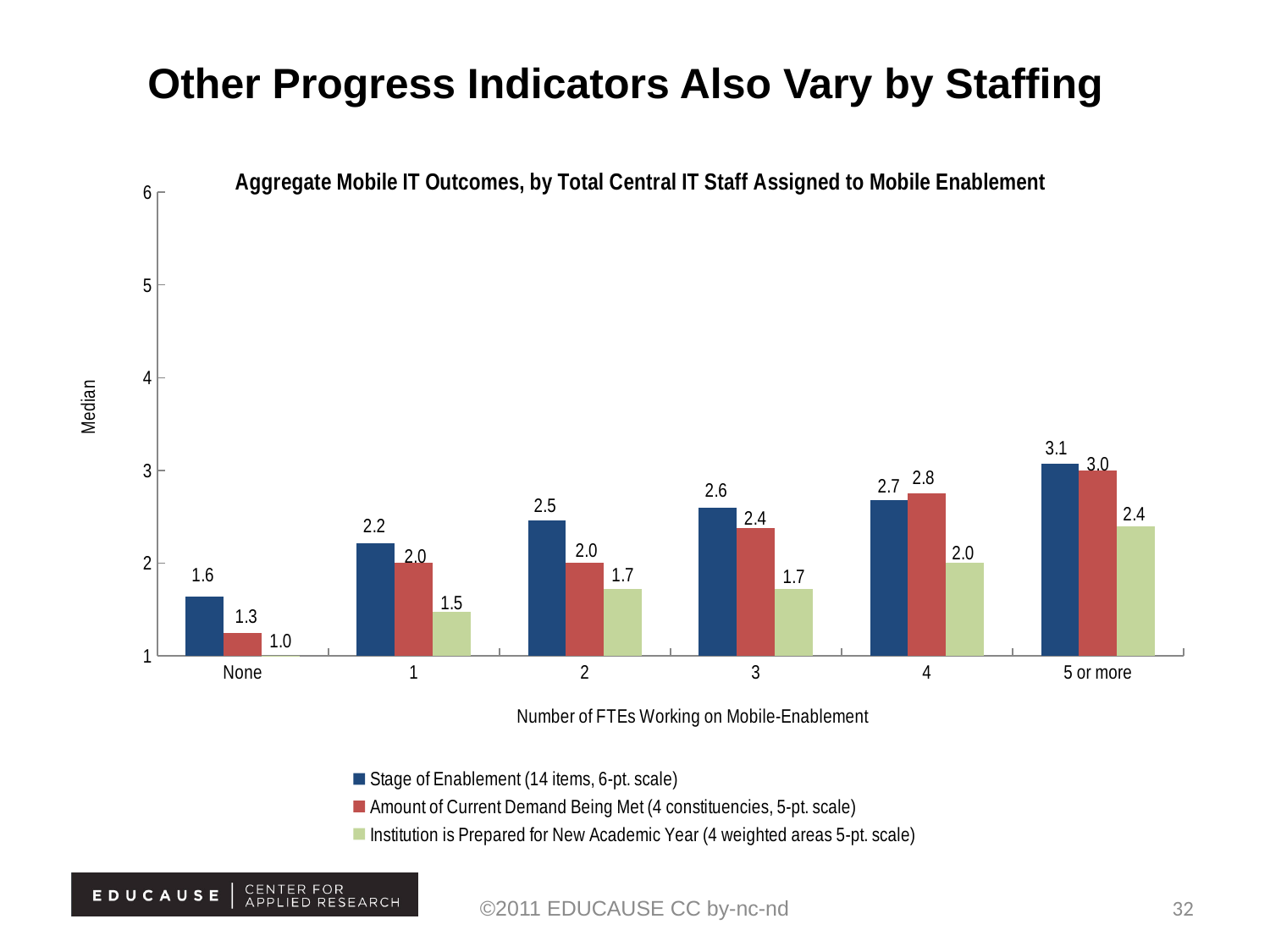
Which is larger for the 4 FTE category: Stage of Enablement or Amount of Current Demand Being Met? Amount of Current Demand Being Met What is the median value for Institution is Prepared for New Academic Year at the 'None' FTE category? 1.0 What is the median Stage of Enablement value for institutions with 2 FTEs working on mobile-enablement? 2.5 Does the Stage of Enablement median rise or fall as the number of FTEs increases from None to 5 or more? rise What is the median Amount of Current Demand Being Met for institutions with 5 or more FTEs? 3.0 How many series does the legend list? 3 What kind of chart is shown on the slide? bar chart What is the difference between the Stage of Enablement median for 5 or more FTEs and for None? 1.5 Which FTE category has the highest Stage of Enablement median? 5 or more Is the Stage of Enablement median for 5 or more FTEs greater or less than 3? greater Which FTE category has the lowest Amount of Current Demand Being Met median? None How many FTE categories are shown on the x axis? 6